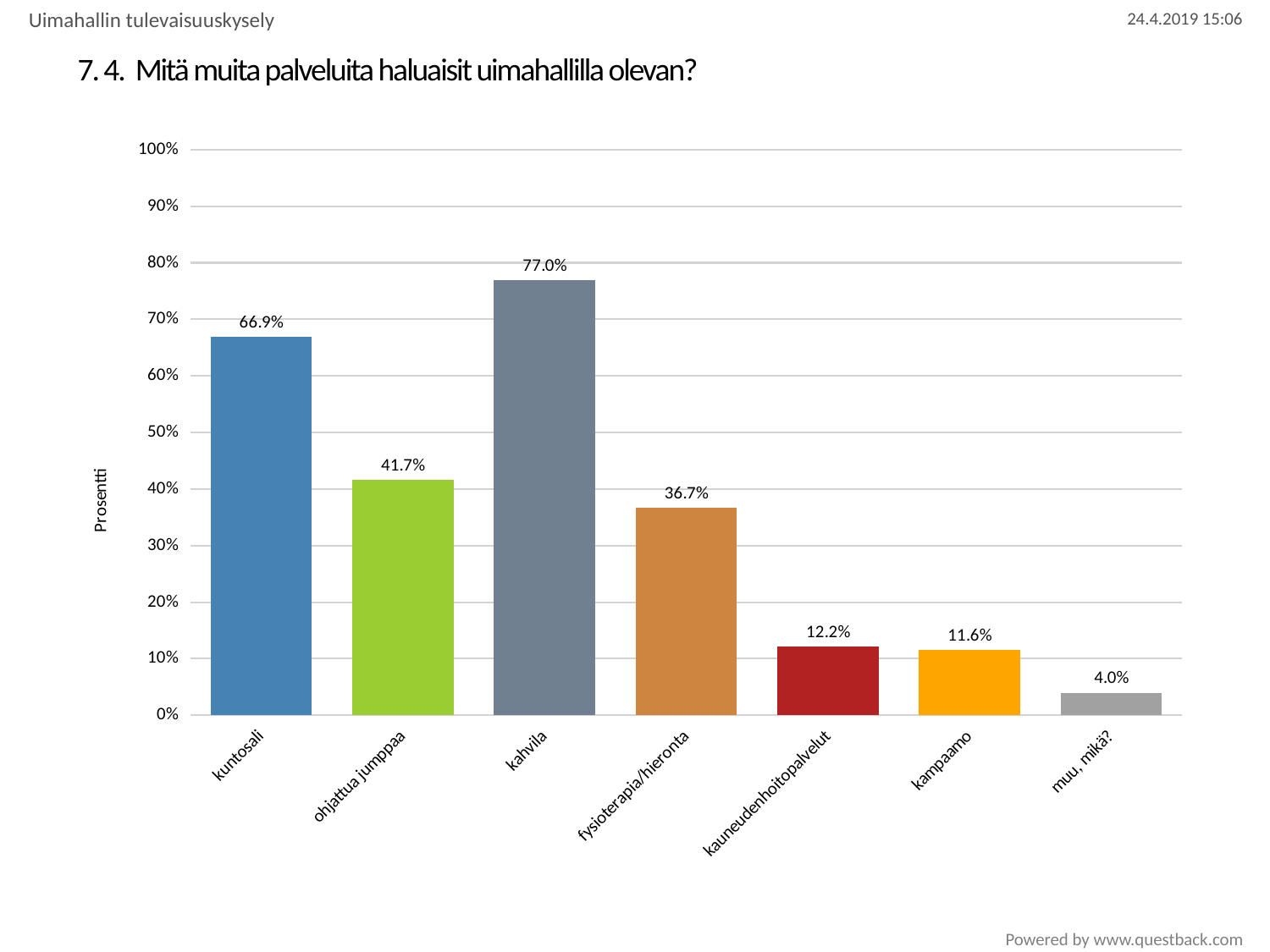
What is the value for kuntosali? 66.9% Which is larger, the value for kuntosali or the value for ohjattua jumppaa? kuntosali What is the value for fysioterapia/hieronta? 36.7% What is the difference between the values for ohjattua jumppaa and fysioterapia/hieronta? 5.0% What is the difference between the values for kahvila and kuntosali? 10.1% Which category has the lowest value? muu, mikä? Which category has the highest value? kahvila What kind of chart is shown on the slide? bar chart What is the value for kampaamo? 11.6% What is the label of the y axis? Prosentti How many categories are shown on the x axis? 7 Is the value for kauneudenhoitopalvelut greater or less than 20%? less